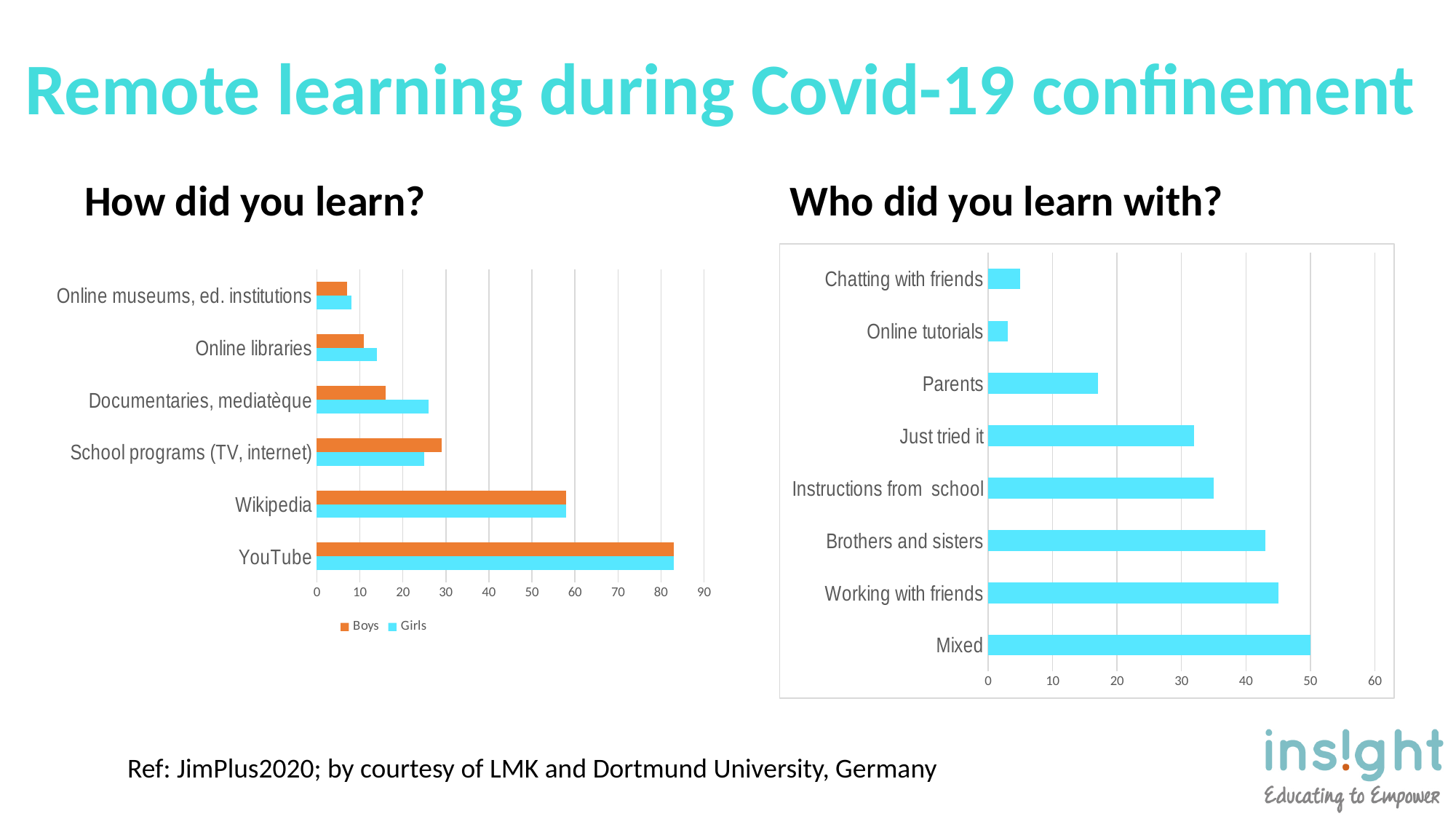
In the "How did you learn?" chart, for Documentaries, mediatèque, which is larger: the Boys value or the Girls value? Girls In the "Who did you learn with?" chart, is the value for Parents greater or less than 20? less In the "How did you learn?" chart, which category has the highest value for Boys? YouTube In the "How did you learn?" chart, is the Boys value for Wikipedia greater or less than 50? greater What are the two legend entries in the "How did you learn?" chart? Boys and Girls In the "Who did you learn with?" chart, is the value for Working with friends greater or less than 40? greater How many categories are shown in the "How did you learn?" chart? 6 What kind of chart is the "How did you learn?" chart? bar chart In the "Who did you learn with?" chart, which category has the lowest value? Online tutorials In the "Who did you learn with?" chart, which category has the highest value? Mixed How many series does the legend of the "How did you learn?" chart list? 2 How many categories are shown in the "Who did you learn with?" chart? 8